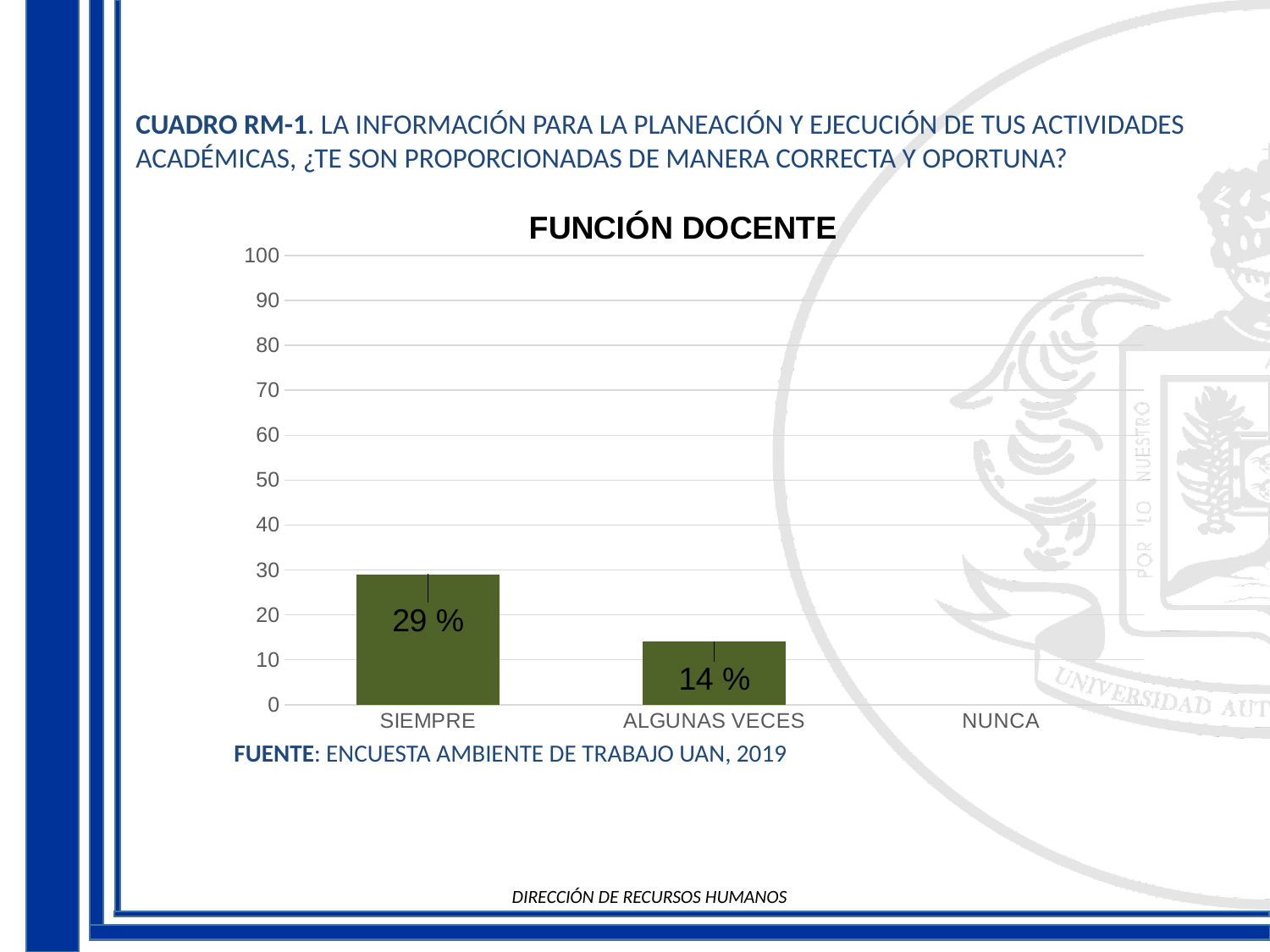
Is the value for ALGUNAS VECES greater or less than 20? less What kind of chart is shown on the slide? bar chart What is the difference between the values for SIEMPRE and ALGUNAS VECES? 15 % What is the value shown for SIEMPRE? 29 % Which category has the highest value? SIEMPRE What is the title of the chart? FUNCIÓN DOCENTE Is the value for SIEMPRE greater or less than 20? greater Which is larger, the value for SIEMPRE or the value for ALGUNAS VECES? SIEMPRE Do the labelled values rise or fall from SIEMPRE to ALGUNAS VECES? fall How many categories are shown on the x axis? 3 What is the highest value shown on the y axis? 100 What is the value shown for ALGUNAS VECES? 14 %